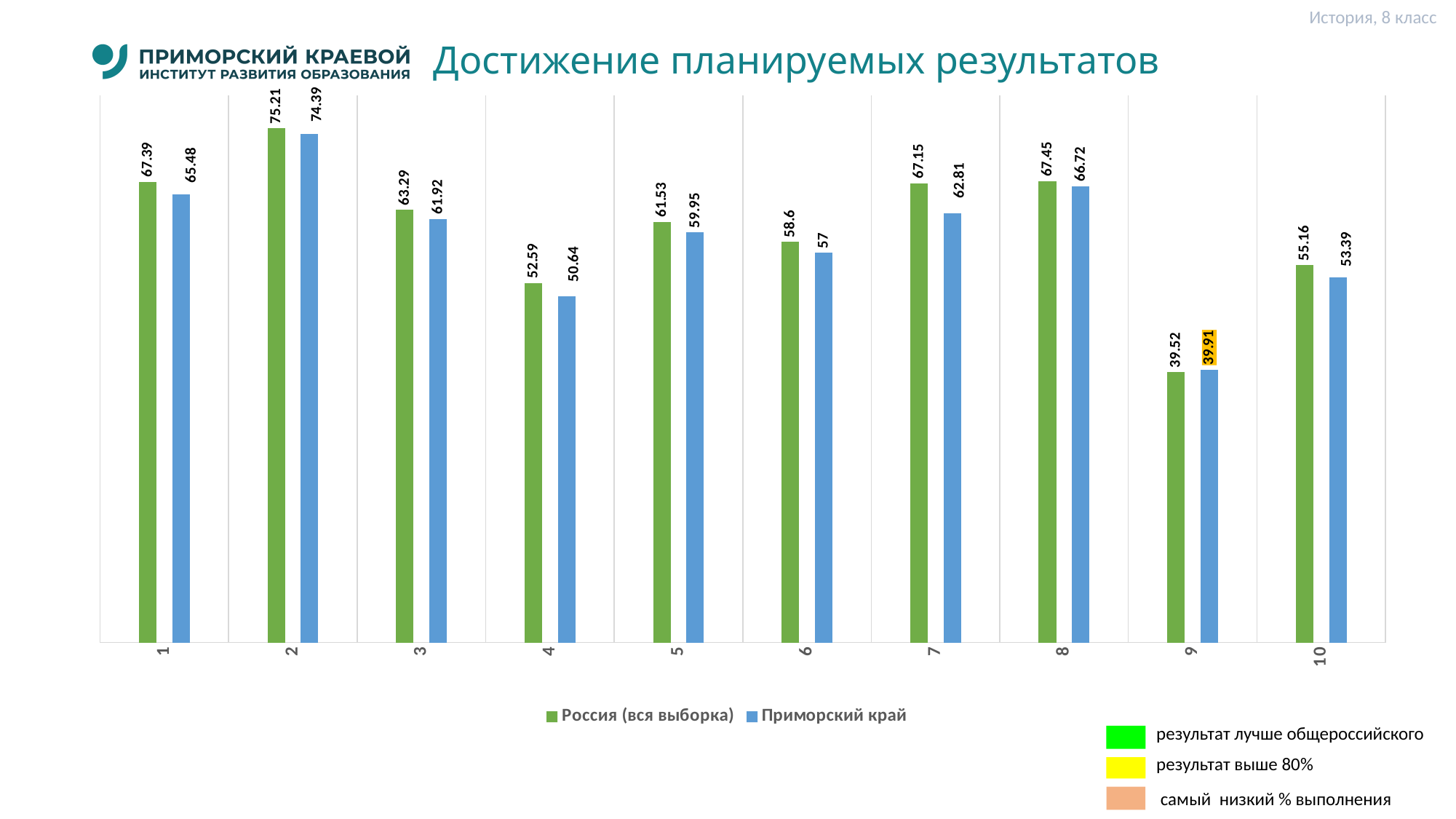
What is the value for Приморский край in category 6? 57 Which category has the lowest value for Россия (вся выборка)? 9 How many categories are shown on the x axis of the chart? 10 In category 9, which series has the larger value: Россия (вся выборка) or Приморский край? Приморский край What type of chart is shown on the slide? bar chart Which category has the highest value for Приморский край? 2 In category 4, which series has the larger value: Россия (вся выборка) or Приморский край? Россия (вся выборка) What is the difference between Россия (вся выборка) and Приморский край in category 7? 4.34 How many series does the chart legend list? 2 What is the value for Россия (вся выборка) in category 2? 75.21 What is the difference between Россия (вся выборка) and Приморский край in category 2? 0.82 What is the value for Приморский край in category 7? 62.81